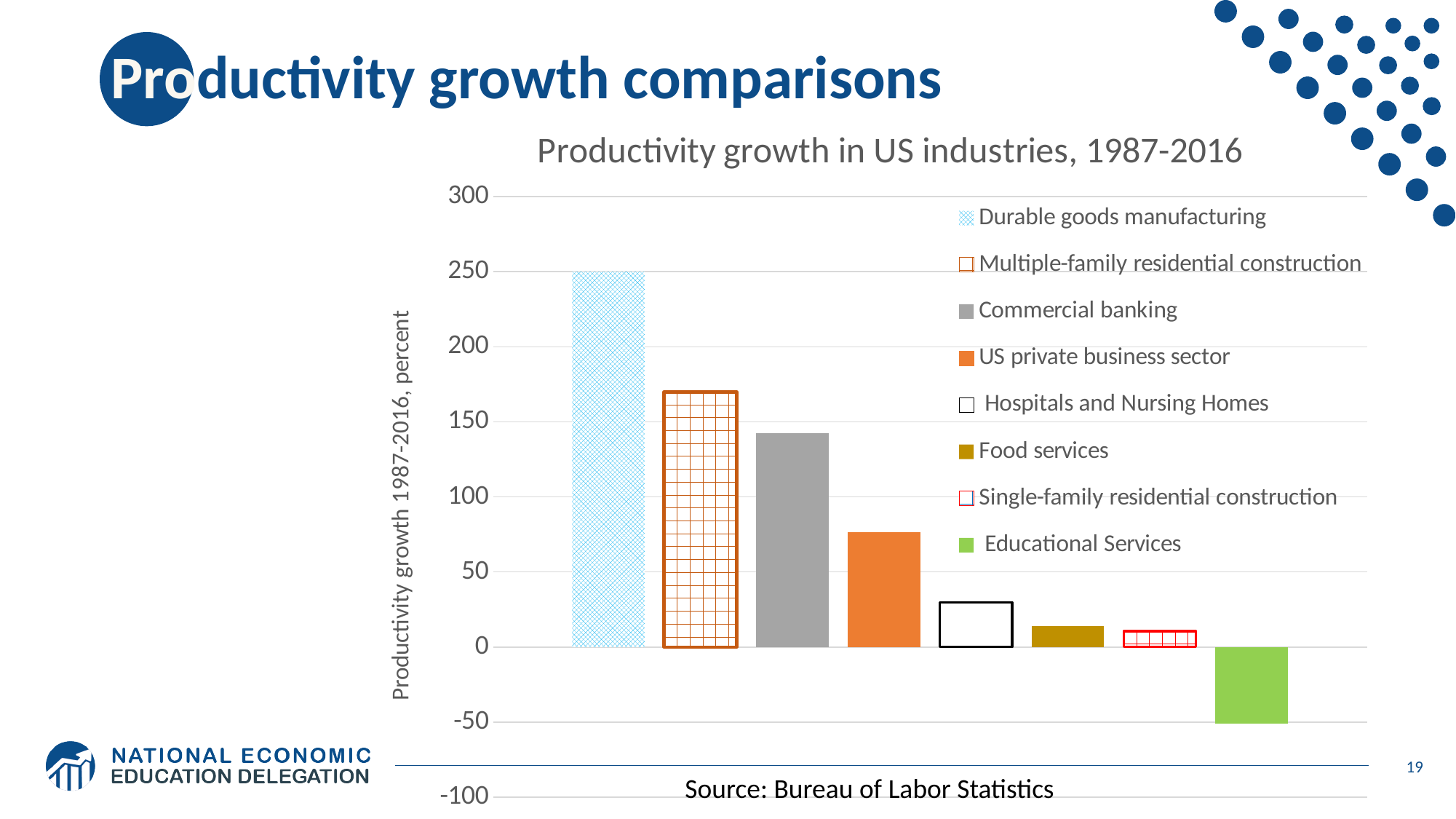
Which is larger, the productivity growth for Food services or for Single-family residential construction? Food services Which industry has the highest productivity growth in the chart? Durable goods manufacturing Is the value for Hospitals and Nursing Homes greater or less than 50? less Which is larger, the productivity growth for Commercial banking or for the US private business sector? Commercial banking Is the value for Multiple-family residential construction greater or less than 150? greater How many bars are plotted in the chart? 8 Is the value for Educational Services greater or less than 0? less How many series does the legend list? 8 What kind of chart is shown on the slide? bar chart What is the title of the chart? Productivity growth in US industries, 1987-2016 Which industry has the lowest productivity growth in the chart? Educational Services